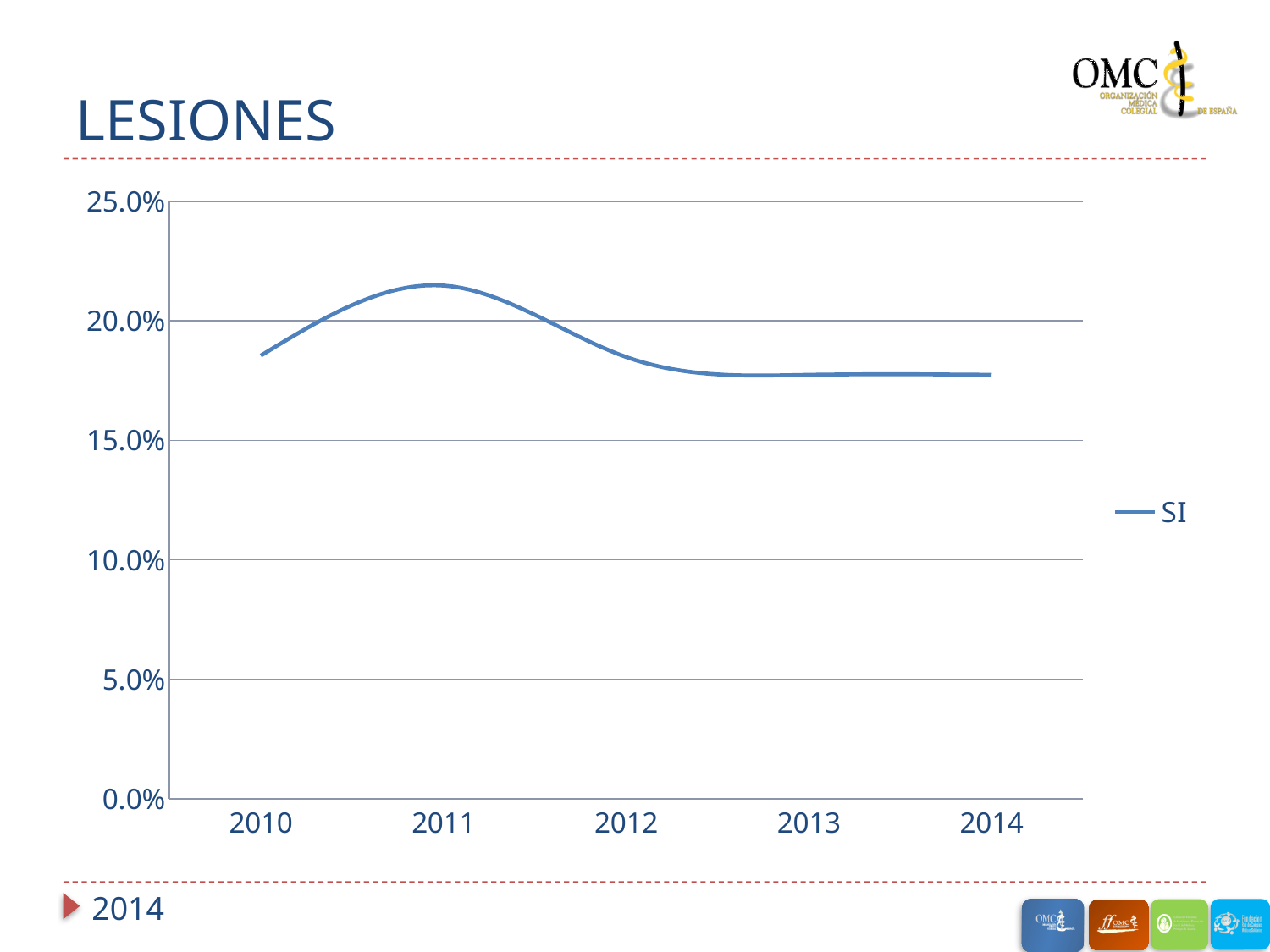
What is the name of the series shown in the legend? SI What kind of chart is shown on the slide? line chart In which year does the SI line reach its highest value? 2011 Is the value for 2011 greater or less than 20.0%? greater Is the value for 2010 greater or less than 20.0%? less Does the SI line rise or fall from 2011 to 2012? fall How many series does the legend list? 1 What is the title of the slide containing the chart? LESIONES Is the value for 2012 greater or less than 20.0%? less Which year has the larger value, 2010 or 2011? 2011 How many years are plotted along the x axis? 5